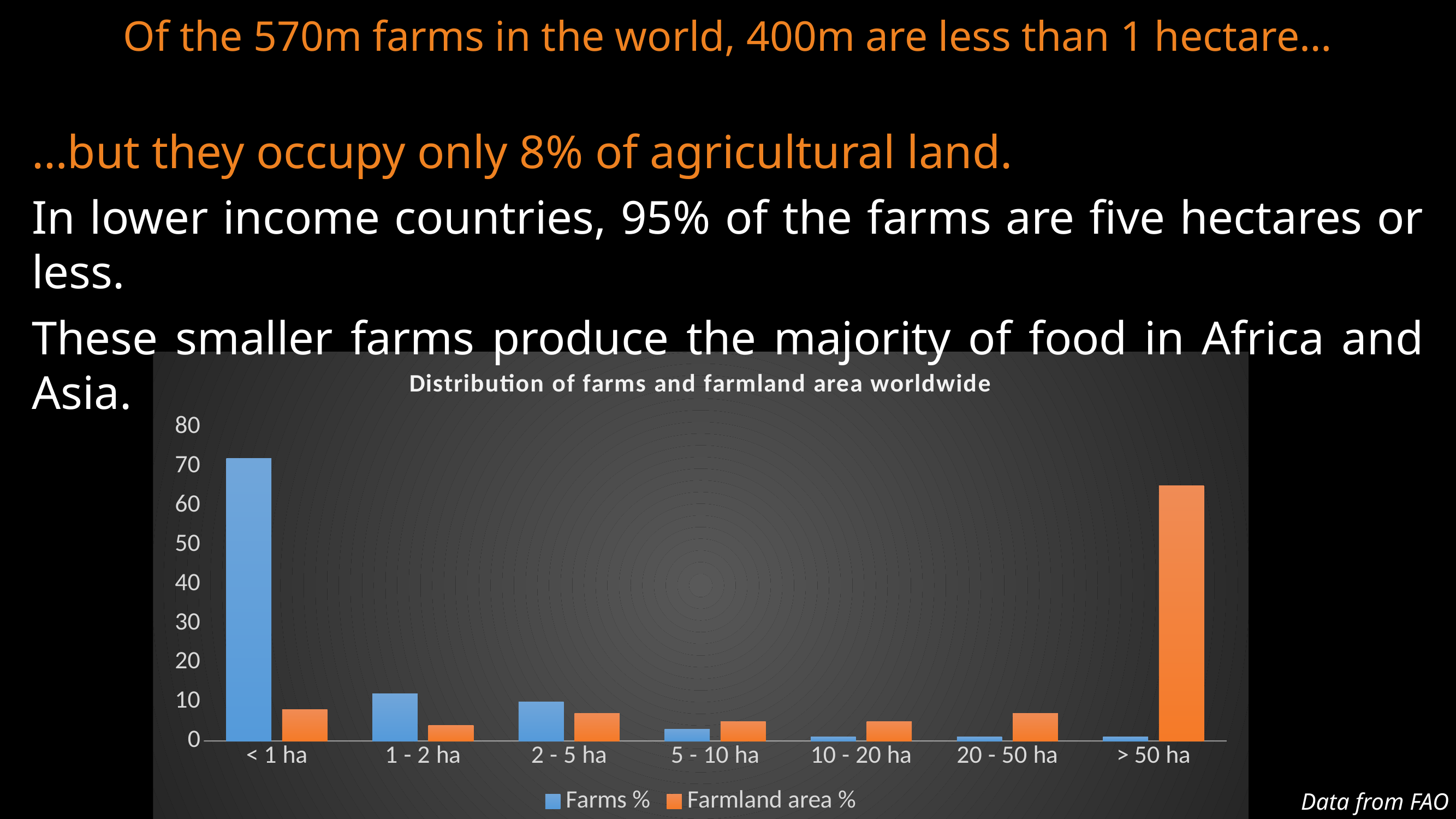
How many farm-size categories are shown on the x axis? 7 Is the Farms % value for 1 - 2 ha greater or less than 10? greater For the > 50 ha category, which is larger: Farms % or Farmland area %? Farmland area % How many series does the chart's legend list? 2 Is the Farmland area % value for > 50 ha greater or less than 60? greater What kind of chart is shown on the slide? bar chart Which farm-size category has the highest Farms % value? < 1 ha Is the Farms % value for < 1 ha greater or less than 60? greater For the < 1 ha category, which is larger: Farms % or Farmland area %? Farms % What is the title of the chart? Distribution of farms and farmland area worldwide Which farm-size category has the highest Farmland area % value? > 50 ha Do the Farms % values rise or fall as farm size increases along the x axis? fall